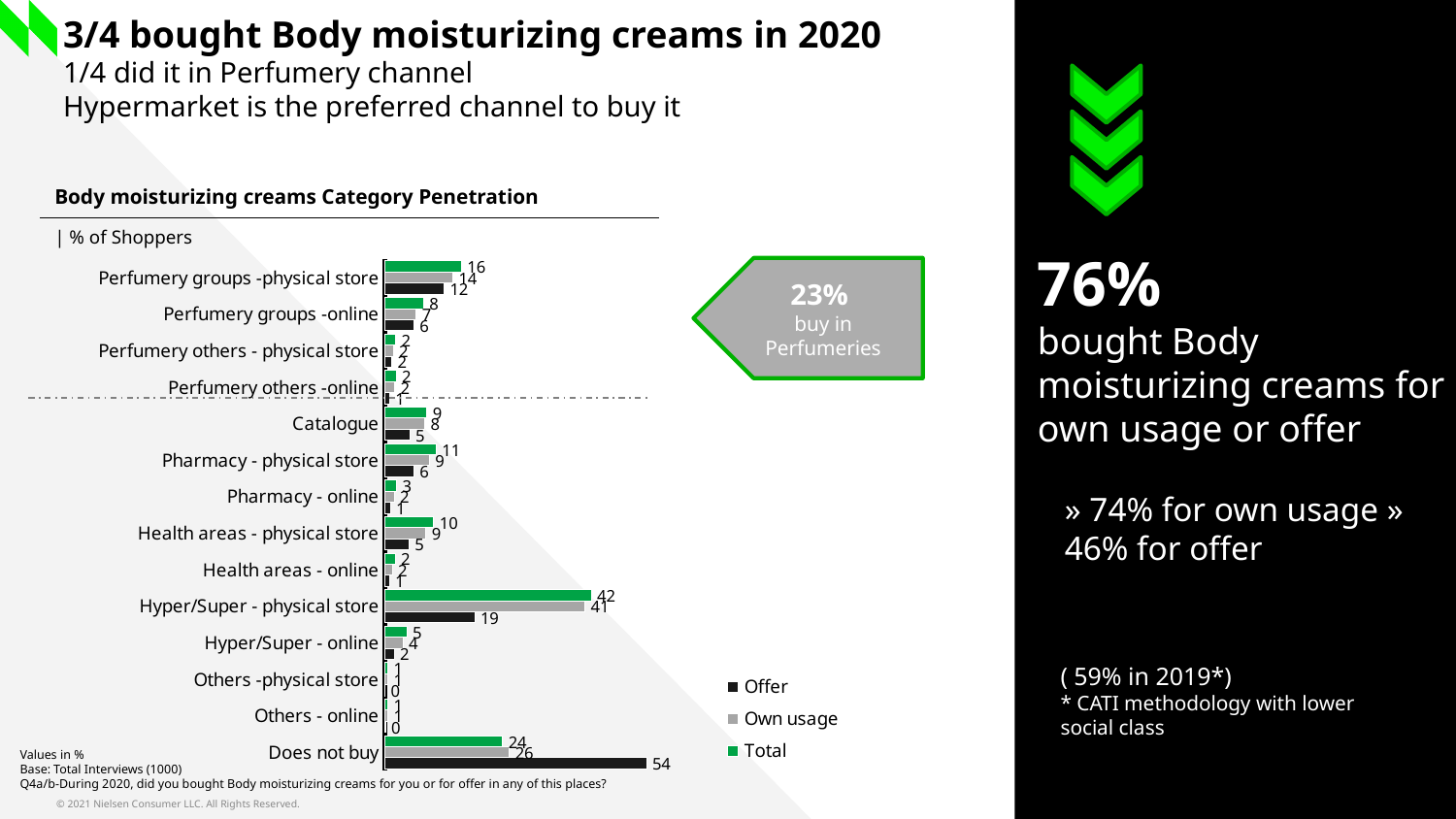
How many series does the legend list? 3 Which has a higher Total value: Pharmacy - physical store or Health areas - physical store? Pharmacy - physical store What kind of chart is shown on the slide? Bar chart What is the Total value for Perfumery groups - online? 8 Which purchase channel has the highest Total value? Hyper/Super - physical store What is the difference between the Total and Offer values for Hyper/Super - physical store? 23 What is the Offer value for Catalogue? 5 What is the Total value for Hyper/Super - physical store? 42 How many categories are shown on the chart? 14 What is the Offer value for Does not buy? 54 What is the Own usage value for Perfumery groups - physical store? 14 What are the three series listed in the chart legend? Offer, Own usage, Total